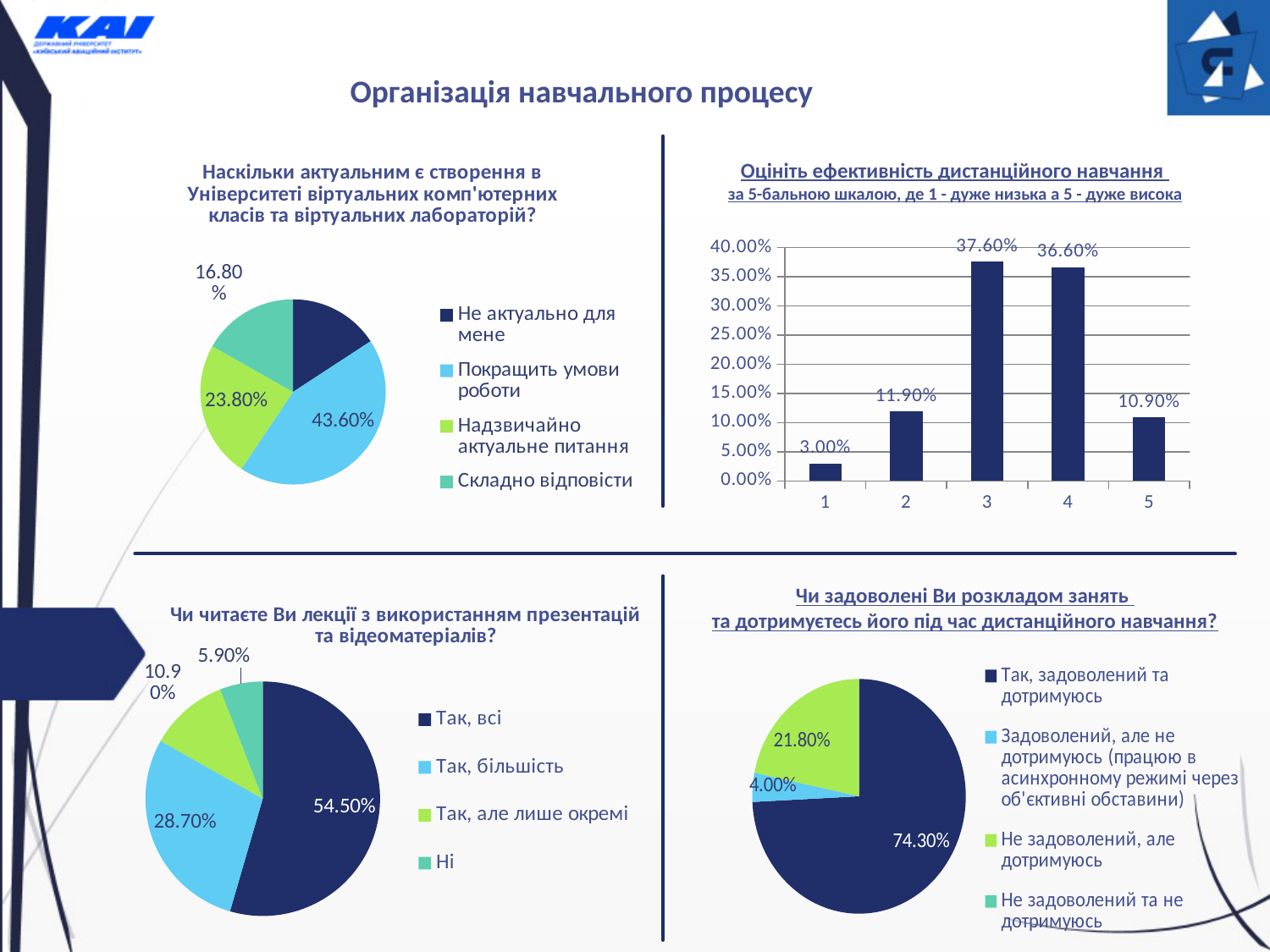
In the bottom-left pie chart 'Чи читаєте Ви лекції з використанням презентацій та відеоматеріалів?', which answer has the largest share? Так, всі In the bar chart 'Оцініть ефективність дистанційного навчання', what is the difference between the values for rating 3 and rating 4? 1.00% In the bar chart 'Оцініть ефективність дистанційного навчання', how many rating categories are shown on the x axis? 5 In the top-left pie chart about virtual computer classes, what share is 'Покращить умови роботи'? 43.60% In the top-left pie chart about virtual computer classes, what share is 'Надзвичайно актуальне питання'? 23.80% In the bottom-right pie chart 'Чи задоволені Ви розкладом занять', how many entries does the legend list? 4 In the bar chart 'Оцініть ефективність дистанційного навчання', what is the value for rating 3? 37.60% In the bar chart 'Оцініть ефективність дистанційного навчання', is the value for rating 2 greater or less than 10.00%? greater In the bar chart 'Оцініть ефективність дистанційного навчання', which rating has the highest value? 3 In the bottom-left pie chart 'Чи читаєте Ви лекції з використанням презентацій та відеоматеріалів?', what share is 'Так, більшість'? 28.70% In the bar chart 'Оцініть ефективність дистанційного навчання', which rating has the lowest value? 1 What kind of chart is used for 'Оцініть ефективність дистанційного навчання'? bar chart